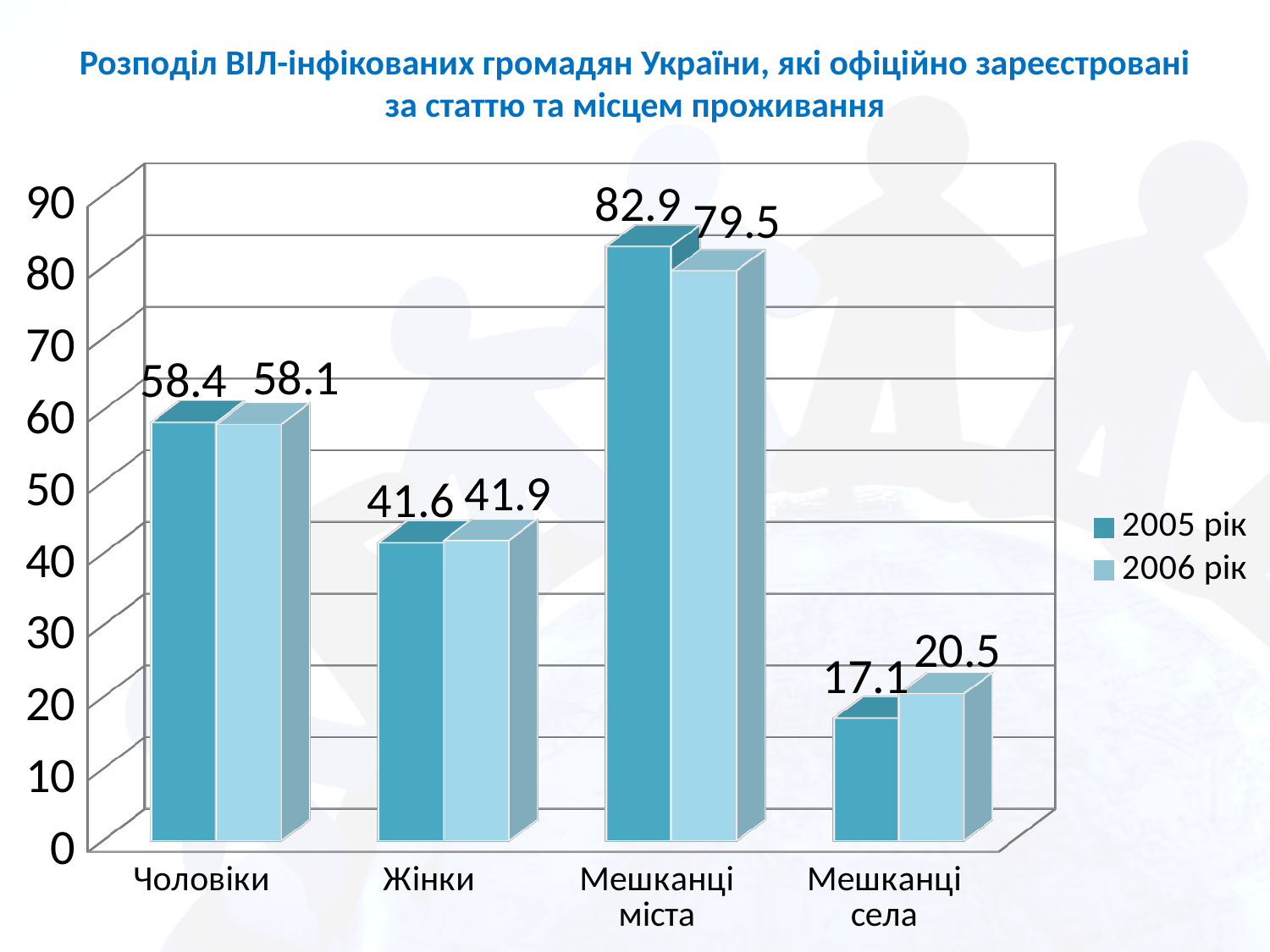
What is the value for Жінки in the 2006 рік series? 41.9 What kind of chart is shown on the slide? bar chart Which is larger for Мешканці села: the 2005 рік value or the 2006 рік value? 2006 рік Which category has the lowest value in the 2006 рік series? Мешканці села How many series does the legend list? 2 What are the two series named in the legend? 2005 рік and 2006 рік Which category has the highest value in the 2005 рік series? Мешканці міста How many categories are shown on the x axis? 4 What is the value for Чоловіки in the 2005 рік series? 58.4 What is the difference between the 2005 рік and 2006 рік values for Мешканці міста? 3.4 Is the 2005 рік value for Жінки greater or less than 50? less What is the value for Мешканці села in the 2006 рік series? 20.5